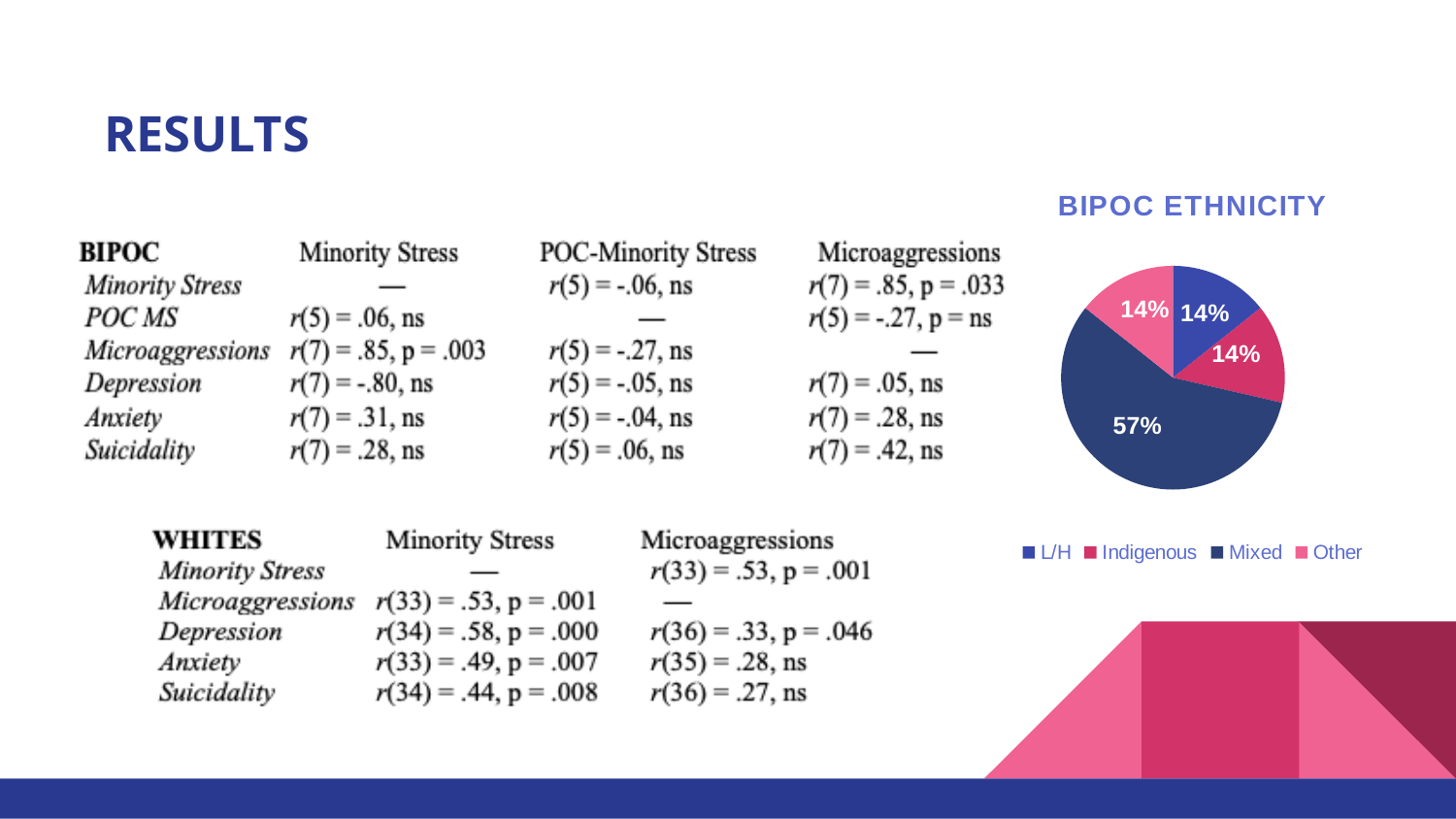
In the BIPOC ETHNICITY pie chart, what percentage is shown for Indigenous? 14% In the BIPOC ETHNICITY pie chart, what is the difference in percentage points between Mixed and Other? 43 Which category has the largest slice in the BIPOC ETHNICITY pie chart? Mixed In the BIPOC ETHNICITY pie chart, how many slices are labelled 14%? 3 How many categories does the legend of the BIPOC ETHNICITY pie chart list? 4 In the BIPOC ETHNICITY pie chart, what percentage is shown for L/H? 14% In the BIPOC ETHNICITY pie chart, what percentage is shown for Other? 14% What is the title of the pie chart on the slide? BIPOC ETHNICITY In the BIPOC ETHNICITY pie chart, which is larger, the Mixed slice or the Indigenous slice? Mixed What kind of chart is shown under the title BIPOC ETHNICITY? pie chart How many slices does the BIPOC ETHNICITY pie chart have? 4 In the BIPOC ETHNICITY pie chart, what percentage is shown for Mixed? 57%